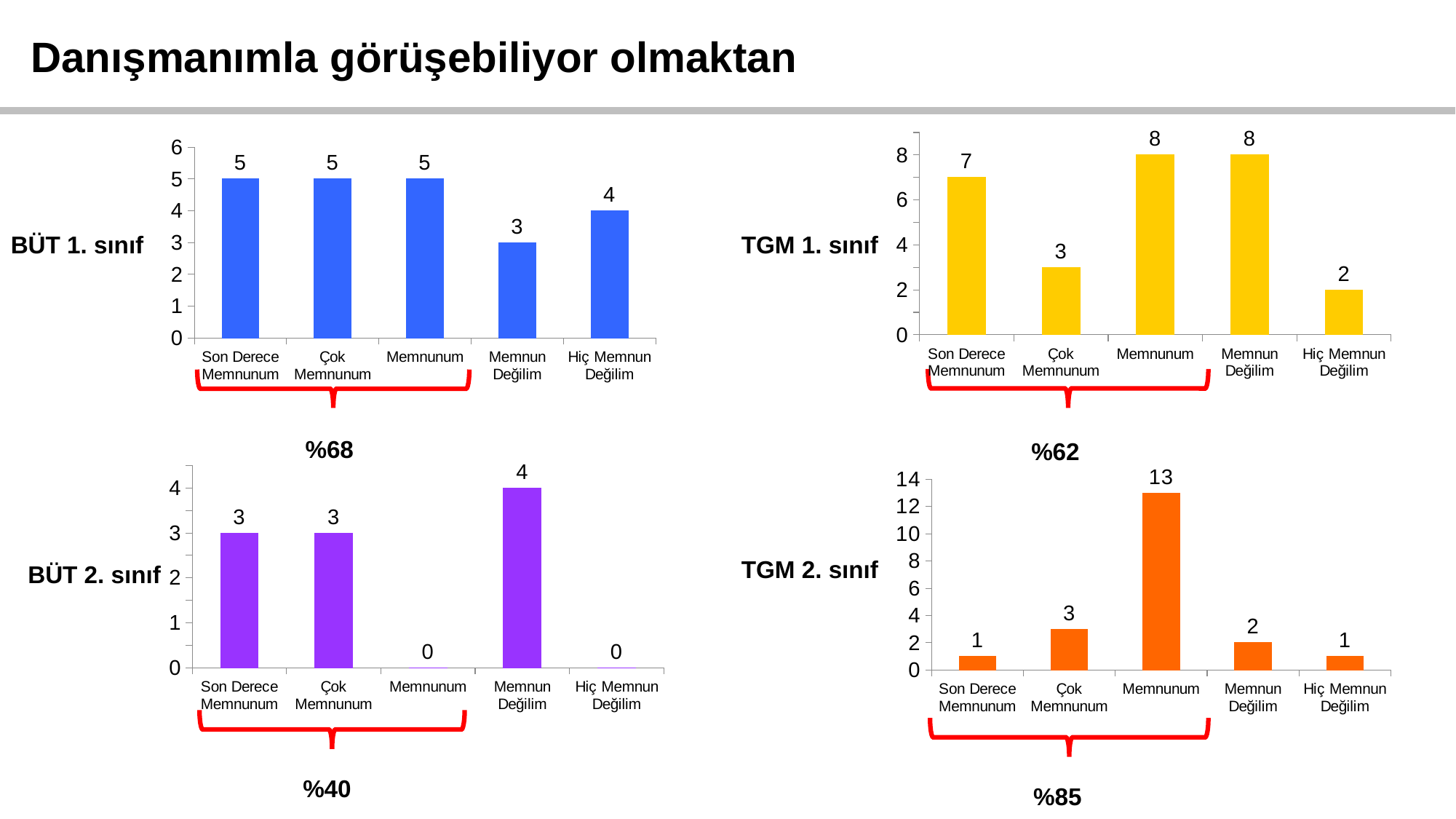
In the TGM 1. sınıf chart, which is larger: the value for Son Derece Memnunum or the value for Çok Memnunum? Son Derece Memnunum In the BÜT 1. sınıf chart, what is the value for Memnun Değilim? 3 What kind of chart is the TGM 2. sınıf chart? bar chart In the TGM 2. sınıf chart, which category has the highest value? Memnunum In the TGM 1. sınıf chart, which category has the lowest value? Hiç Memnun Değilim What percentage is shown below the bracket under the TGM 2. sınıf chart? %85 In the BÜT 2. sınıf chart, what is the value for Hiç Memnun Değilim? 0 In the TGM 2. sınıf chart, what is the difference between the values for Memnunum and Çok Memnunum? 10 What colour are the bars in the TGM 1. sınıf chart? yellow How many categories are shown in the BÜT 1. sınıf chart? 5 In the BÜT 2. sınıf chart, what is the difference between the values for Memnun Değilim and Çok Memnunum? 1 In the TGM 1. sınıf chart, what is the value for Son Derece Memnunum? 7